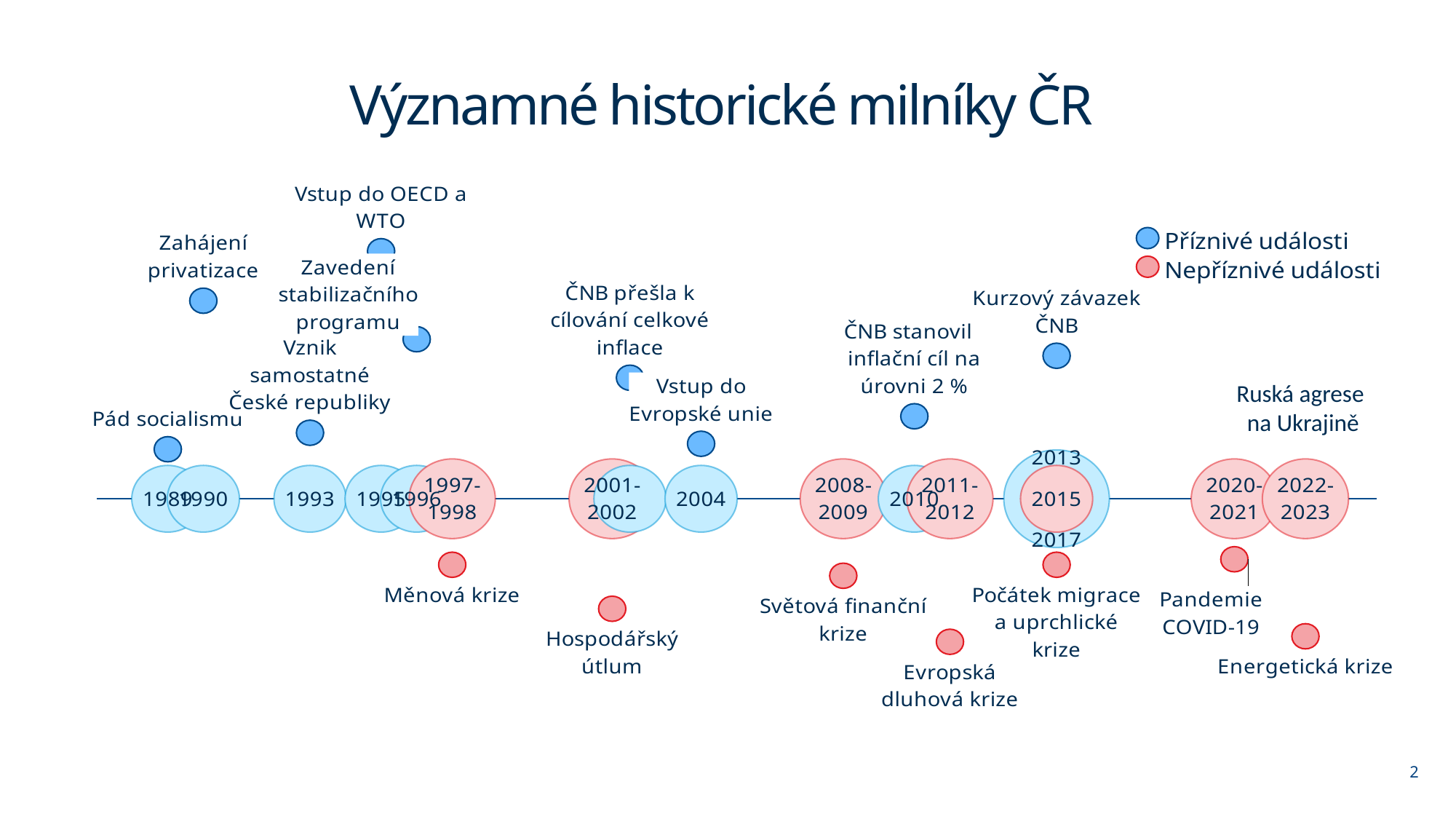
Which event is marked at 1989 on the timeline? Pád socialismu Which event is marked at 2001-2002 on the timeline? Hospodářský útlum Which event is marked at 2020-2021 on the timeline? Pandemie COVID-19 Is the event 'Vstup do Evropské unie' classified as a favourable or unfavourable event on the timeline? Favourable (Příznivé události) What kind of chart is shown on the slide? Timeline What are the two legend entries on the timeline? Příznivé události, Nepříznivé události Which event is marked at 1997-1998 on the timeline? Měnová krize Which event is marked at 2004 on the timeline? Vstup do Evropské unie Which colour marks the unfavourable events (Nepříznivé události) on the timeline? Red How many entries does the legend of the timeline list? 2 Which event is marked at 2008-2009 on the timeline? Světová finanční krize